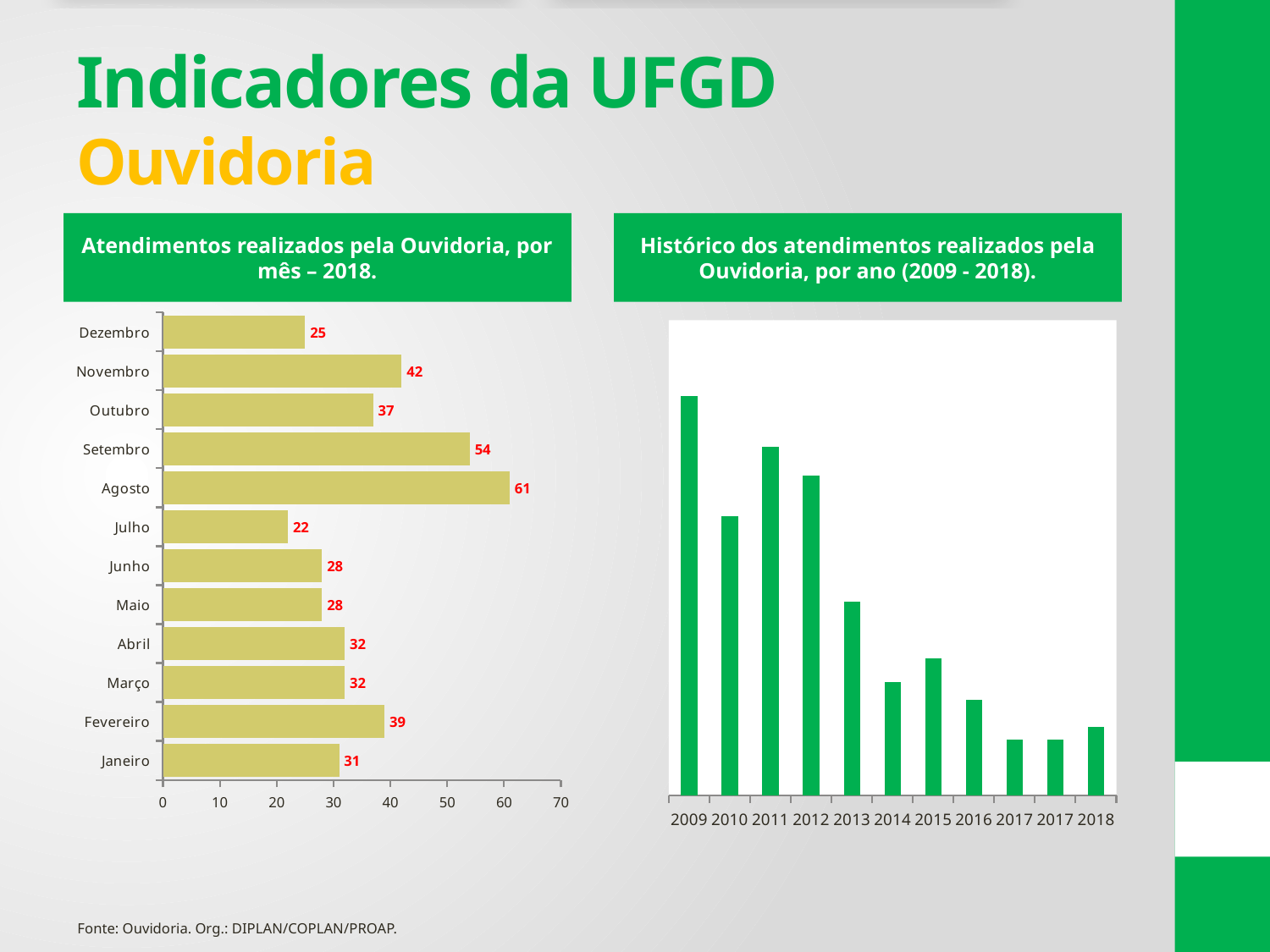
In the chart 'Atendimentos realizados pela Ouvidoria, por mês – 2018', what is the value for Fevereiro? 39 In the chart 'Atendimentos realizados pela Ouvidoria, por mês – 2018', what is the difference between the values for Setembro and Outubro? 17 In the chart 'Histórico dos atendimentos realizados pela Ouvidoria, por ano (2009 - 2018)', do the values generally rise or fall from 2009 to 2017? Fall In the chart 'Atendimentos realizados pela Ouvidoria, por mês – 2018', how many months are shown? 12 In the chart 'Atendimentos realizados pela Ouvidoria, por mês – 2018', what is the value for Agosto? 61 In the chart 'Histórico dos atendimentos realizados pela Ouvidoria, por ano (2009 - 2018)', which is larger, the bar for 2011 or the bar for 2010? 2011 In the chart 'Histórico dos atendimentos realizados pela Ouvidoria, por ano (2009 - 2018)', how many bars are shown? 11 In the chart 'Histórico dos atendimentos realizados pela Ouvidoria, por ano (2009 - 2018)', which year has the highest bar? 2009 In the chart 'Atendimentos realizados pela Ouvidoria, por mês – 2018', which month has the lowest value? Julho In the chart 'Atendimentos realizados pela Ouvidoria, por mês – 2018', which month has the highest value? Agosto In the chart 'Atendimentos realizados pela Ouvidoria, por mês – 2018', which is larger, the value for Novembro or the value for Dezembro? Novembro What kind of chart is 'Atendimentos realizados pela Ouvidoria, por mês – 2018'? Bar chart